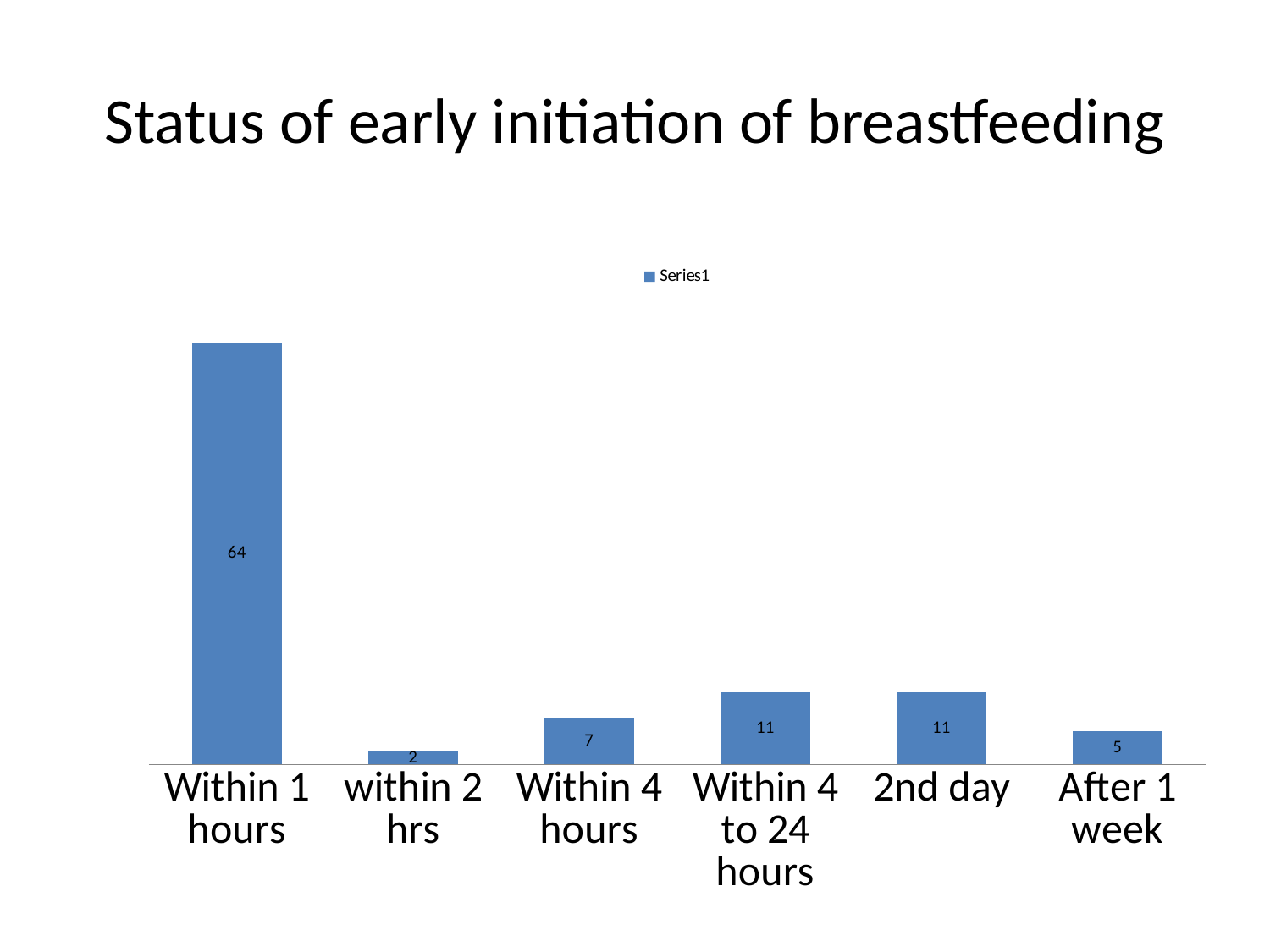
How many series does the legend list? 1 What is the value for "within 2 hrs"? 2 What kind of chart is shown on the slide? bar chart Which category has the lowest value? within 2 hrs What is the difference between the values for "Within 1 hours" and "2nd day"? 53 What is the title of the slide? Status of early initiation of breastfeeding Which is larger, the value for "Within 4 hours" or the value for "After 1 week"? Within 4 hours How many categories are shown on the x axis? 6 What is the value for "Within 1 hours"? 64 Which category has the highest value? Within 1 hours What is the value for "Within 4 hours"? 7 What is the value for "After 1 week"? 5